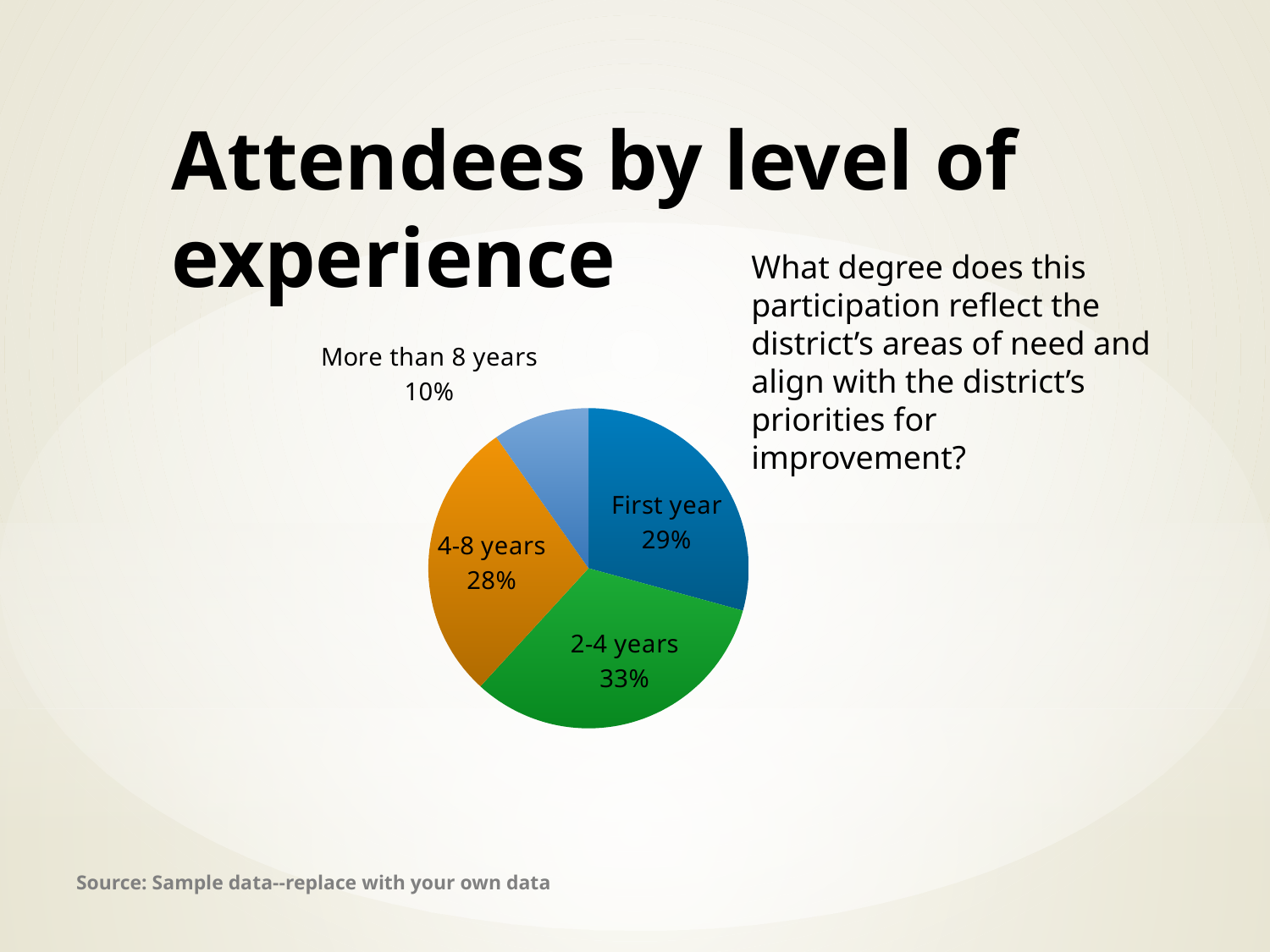
What is the difference in percentage points between the First year slice and the 4-8 years slice? 1 Which experience level has the largest share of attendees? 2-4 years What colour is the 2-4 years slice? green What percentage of attendees have 4-8 years of experience? 28% What share of attendees have more than 8 years of experience? 10% Which experience level has the smallest share of attendees? More than 8 years What share of attendees are in their first year? 29% How many slices does the pie chart have? 4 What is the difference in percentage points between the 2-4 years slice and the More than 8 years slice? 23 Which is larger, the share for First year or the share for More than 8 years? First year What percentage of attendees have 2-4 years of experience? 33% What kind of chart is shown on the slide? pie chart